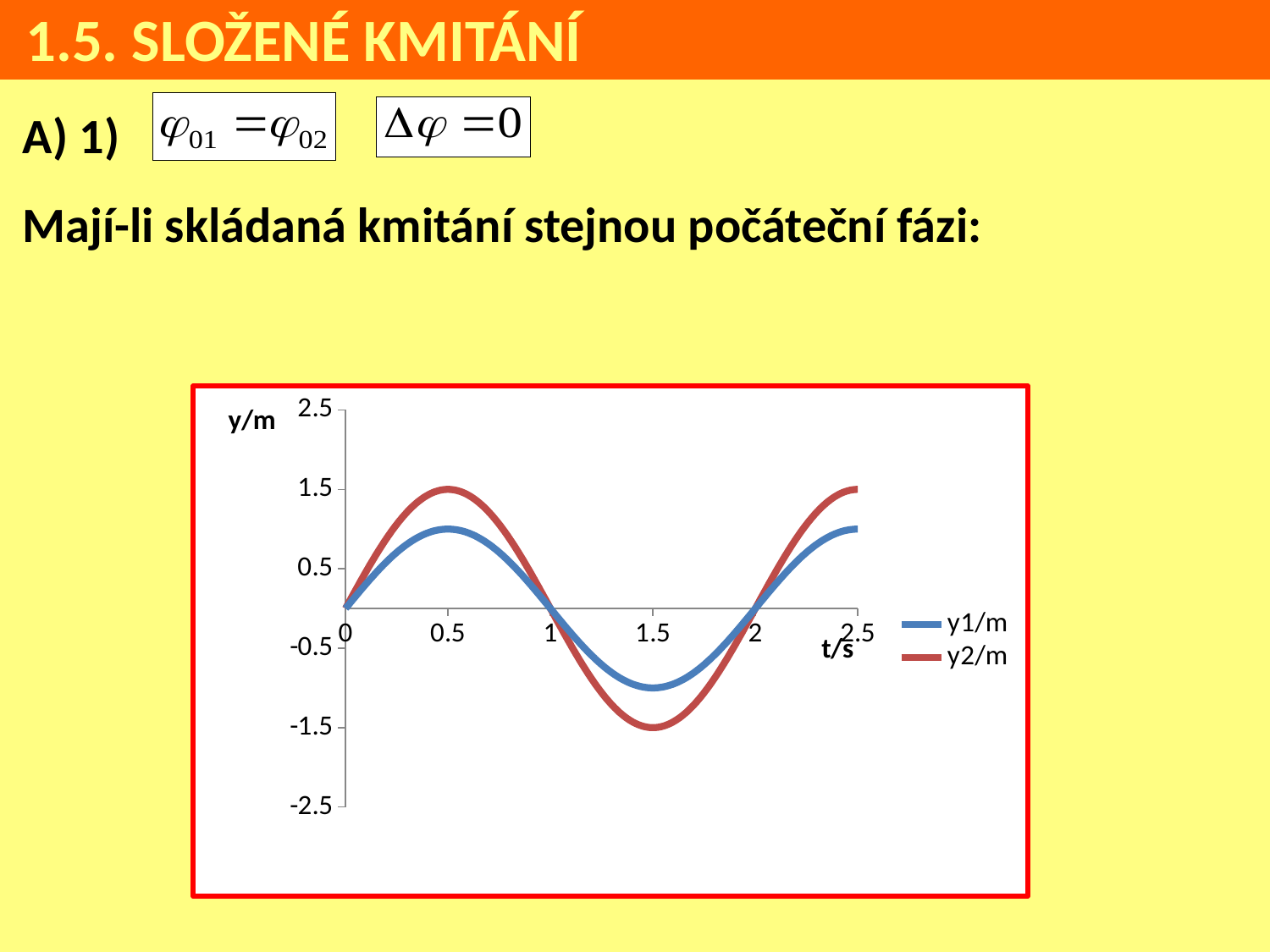
How many series does the legend list? 2 Is the value of y2/m at t = 2.5 greater or less than 0.5? greater What is the value of y2/m at t = 0.5? 1.5 At t = 0.5, which series has the larger value, y1/m or y2/m? y2/m What is the value of y2/m at t = 1.5? -1.5 What are the two series names listed in the legend? y1/m and y2/m What kind of chart is shown on the slide? line chart Is the value of y1/m at t = 0.5 greater or less than 0.5? greater Is the value of y1/m at t = 1.5 greater or less than -0.5? less What is the label of the horizontal axis of the chart? t/s Which series reaches the higher peak value? y2/m Between t = 0.5 and t = 1.5, does the y2/m curve rise or fall? fall